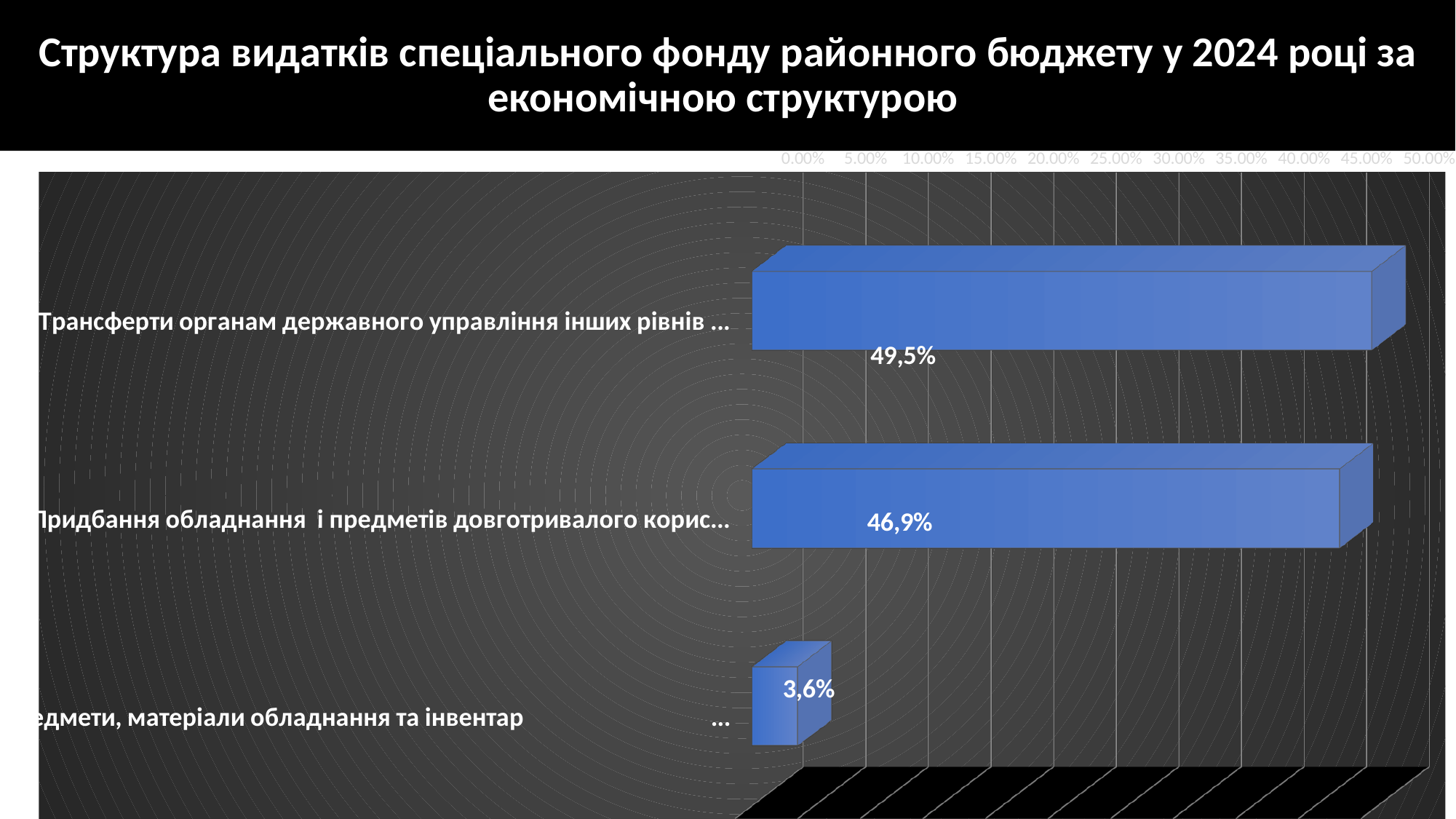
Which category has the lowest value? матеріали обладнання та інвентар (bottom bar) What is the difference between the values for 'Придбання обладнання і предметів довготривалого корис...' and the bottom bar 'матеріали обладнання та інвентар'? 43,3% Is the value for 'Трансферти органам державного управління інших рівнів' greater or less than 45.00%? greater What kind of chart is shown on the slide? Bar chart What is the difference between the values for 'Трансферти органам державного управління інших рівнів' and 'Придбання обладнання і предметів довготривалого корис...'? 2,6% How many categories are shown in the chart? 3 Which is larger: the value for 'Придбання обладнання і предметів довготривалого корис...' or the value for the bottom bar 'матеріали обладнання та інвентар'? Придбання обладнання і предметів довготривалого корис... Which category has the highest value? Трансферти органам державного управління інших рівнів What is the value for the bottom bar, 'матеріали обладнання та інвентар'? 3,6% What is the value for 'Трансферти органам державного управління інших рівнів'? 49,5% What year does the slide title say the expenditure structure refers to? 2024 What is the value for 'Придбання обладнання і предметів довготривалого корис...'? 46,9%